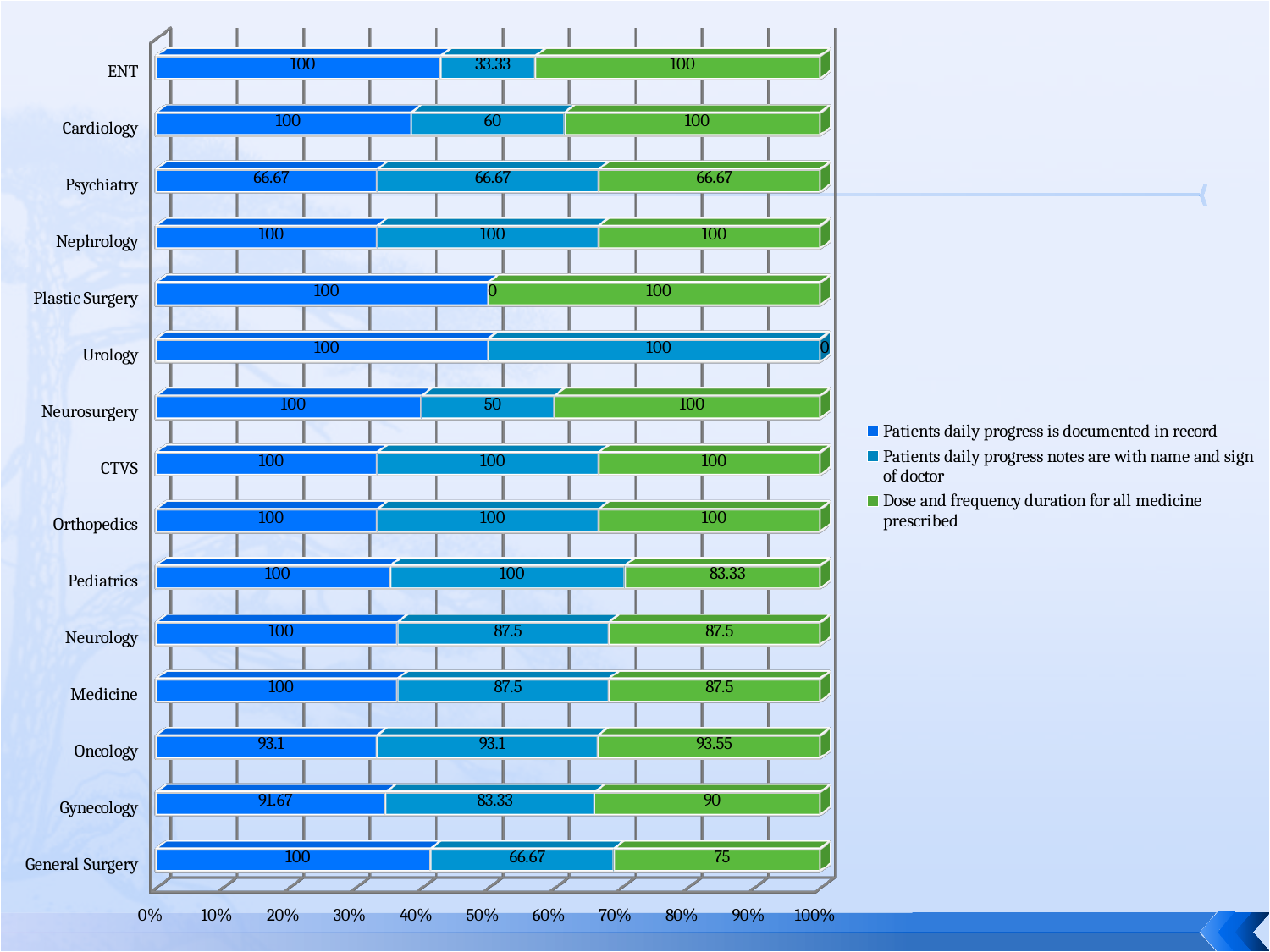
What is the value for Oncology in the series 'Dose and frequency duration for all medicine prescribed'? 93.55 What is the value for General Surgery in the series 'Dose and frequency duration for all medicine prescribed'? 75 What kind of chart is shown on the slide? bar chart What is the value for Pediatrics in the series 'Dose and frequency duration for all medicine prescribed'? 83.33 What is the value for Cardiology in the series 'Patients daily progress notes are with name and sign of doctor'? 60 How many departments (categories) are listed on the chart? 15 In the series 'Patients daily progress notes are with name and sign of doctor', which is larger: the value for Cardiology or the value for Neurosurgery? Cardiology How many series does the legend list? 3 For Gynecology, what is the difference between the value for 'Patients daily progress is documented in record' and the value for 'Patients daily progress notes are with name and sign of doctor'? 8.34 What is the value for Plastic Surgery in the series 'Patients daily progress notes are with name and sign of doctor'? 0 What is the value for ENT in the series 'Patients daily progress notes are with name and sign of doctor'? 33.33 Which department has the lowest value in the series 'Patients daily progress is documented in record'? Psychiatry